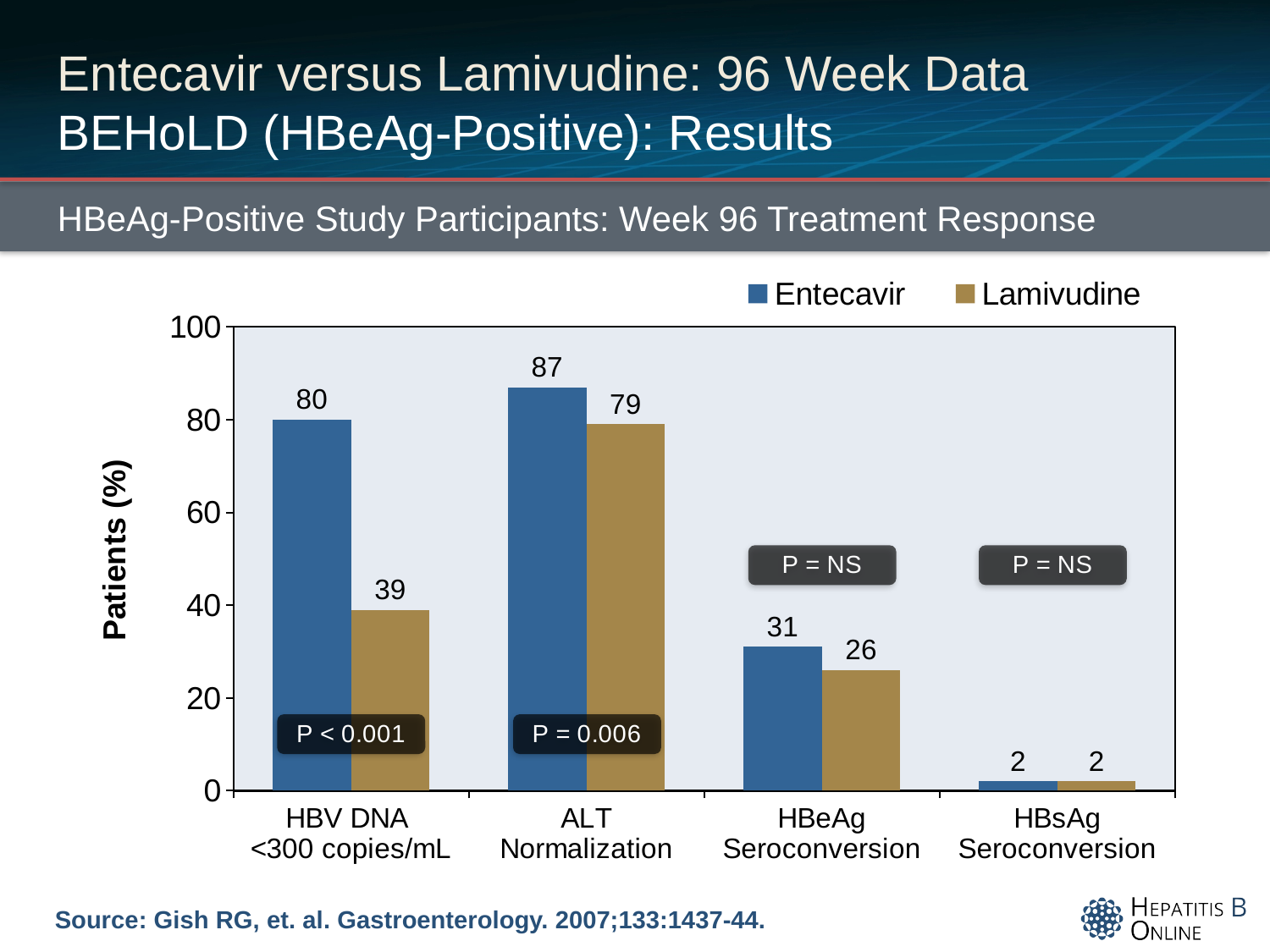
Is the Lamivudine value for HBV DNA <300 copies/mL greater or less than 40? less What is the difference between the Entecavir and Lamivudine values for HBV DNA <300 copies/mL? 41 What kind of chart is shown on the slide? bar chart What is the value for Lamivudine in the HBeAg Seroconversion category? 26 Which category has the highest Entecavir value? ALT Normalization Which category has the lowest Lamivudine value? HBsAg Seroconversion What is the label of the y axis? Patients (%) How many series does the legend list? 2 Which is larger in the HBeAg Seroconversion category, Entecavir or Lamivudine? Entecavir What is the value for Lamivudine in the ALT Normalization category? 79 How many categories are shown on the x axis? 4 What is the value for Entecavir in the HBV DNA <300 copies/mL category? 80